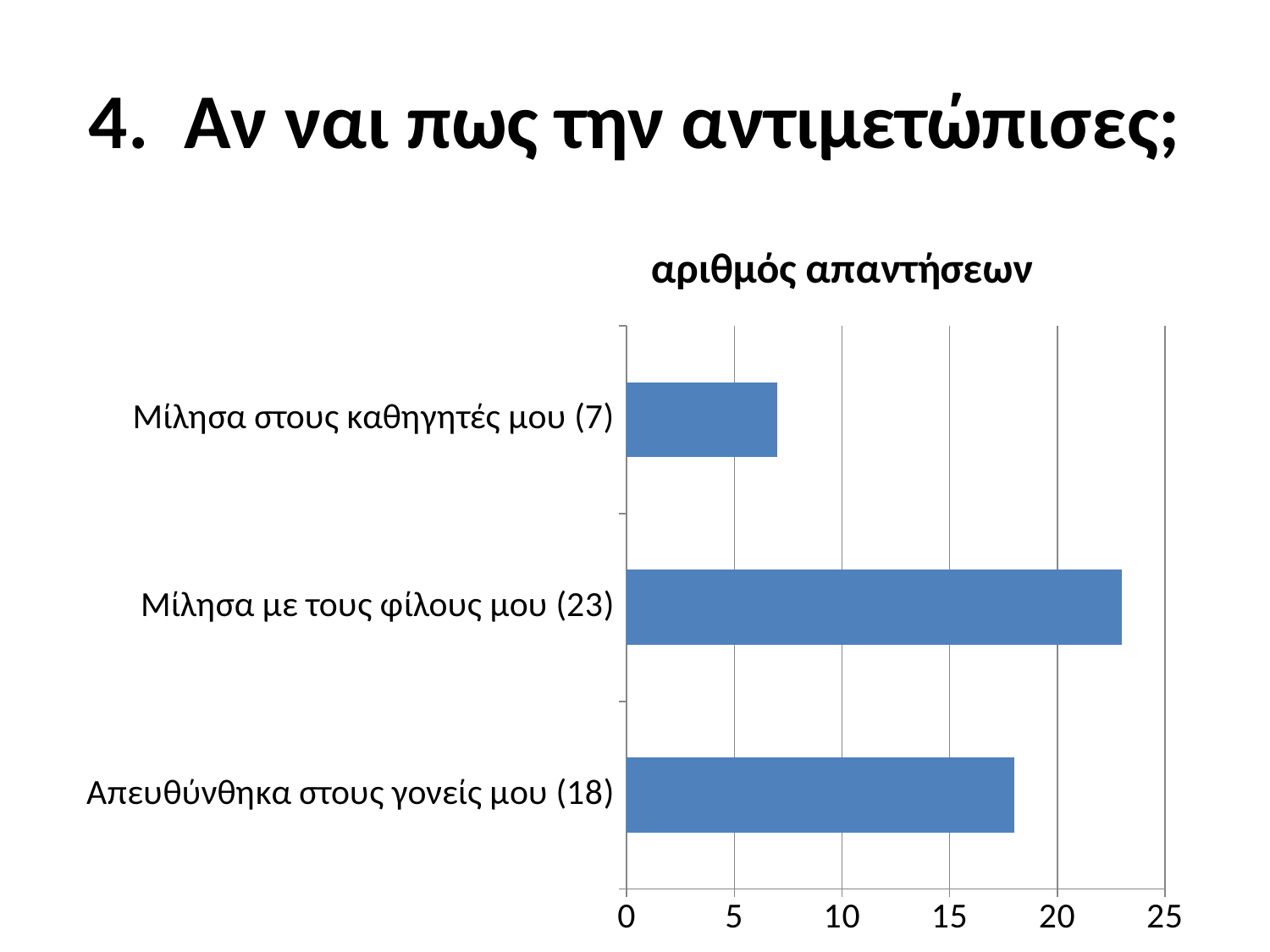
What kind of chart is shown on the slide? bar chart What is the value for "Μίλησα στους καθηγητές μου"? 7 What is the value for "Απευθύνθηκα στους γονείς μου"? 18 What is the difference between the values for "Απευθύνθηκα στους γονείς μου" and "Μίλησα στους καθηγητές μου"? 11 What is the value for "Μίλησα με τους φίλους μου"? 23 Which category has the highest value? Μίλησα με τους φίλους μου Which category has the lowest value? Μίλησα στους καθηγητές μου Which is larger, the value for "Απευθύνθηκα στους γονείς μου" or the value for "Μίλησα στους καθηγητές μου"? Απευθύνθηκα στους γονείς μου What is the title of the chart? αριθμός απαντήσεων What is the difference between the values for "Μίλησα με τους φίλους μου" and "Απευθύνθηκα στους γονείς μου"? 5 Is the value for "Μίλησα με τους φίλους μου" greater or less than 20? greater How many categories does the chart show? 3